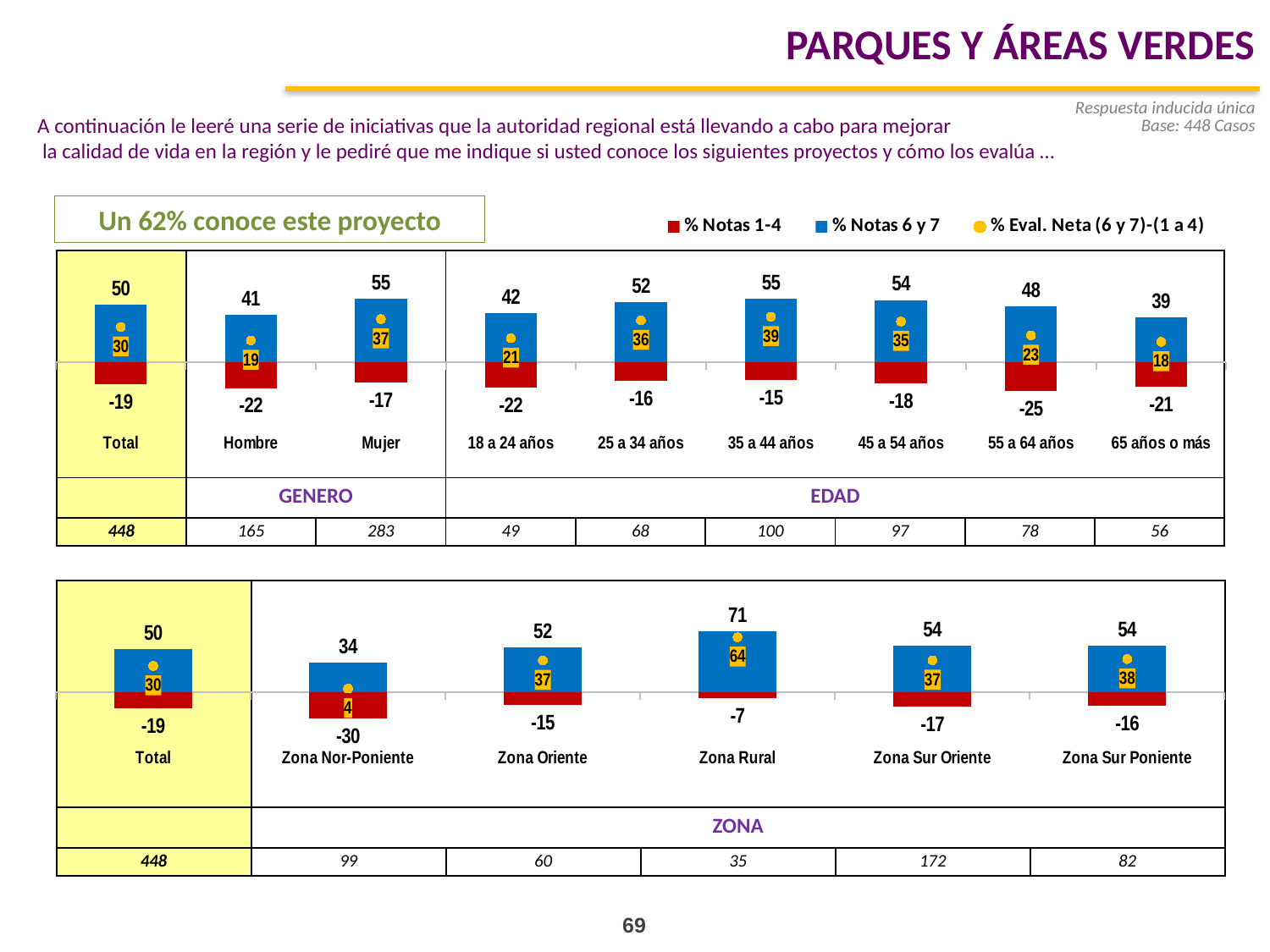
What kind of chart is the bottom chart? Combination bar and line chart (bars with dot markers) In the top chart, what is the % Eval. Neta value for 35 a 44 años? 39 In the bottom chart, which zone has the highest % Eval. Neta value? Zona Rural In the bottom chart, what is the % Notas 1-4 value for Zona Nor-Poniente? -30 In the top chart, which age group has the lowest % Notas 6 y 7 value? 65 años o más In the bottom chart, what is the % Eval. Neta value for Zona Sur Poniente? 38 In the top chart, what is the % Notas 6 y 7 value for Mujer? 55 In the bottom chart, which is larger, the % Notas 6 y 7 value for Zona Oriente or for Zona Nor-Poniente? Zona Oriente In the bottom chart, what is the % Notas 6 y 7 value for Zona Rural? 71 In the top chart, what is the % Notas 1-4 value for 55 a 64 años? -25 In the top chart, what is the difference between the % Notas 6 y 7 values for Mujer and Hombre? 14 How many series does the legend list? 3